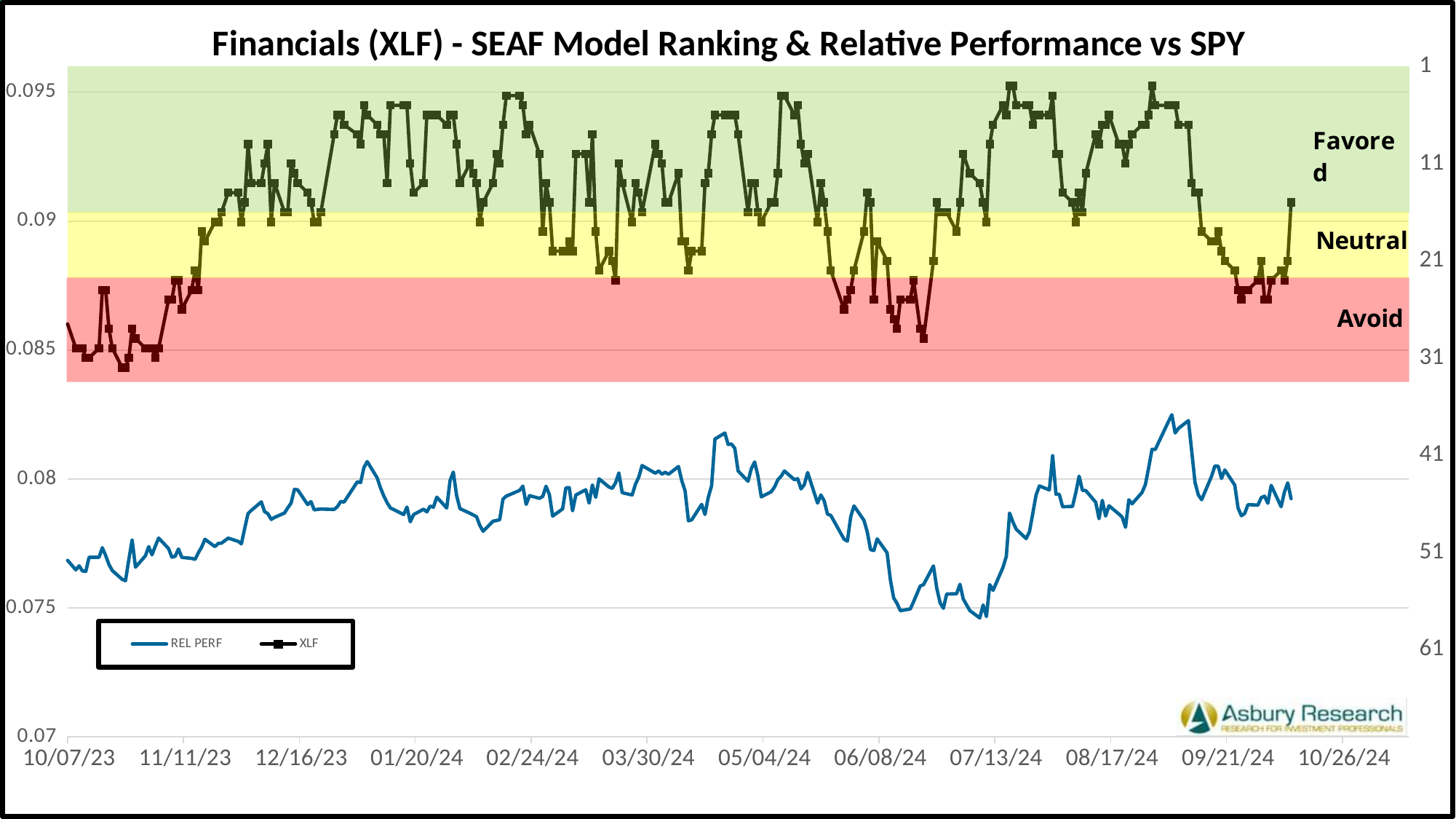
Is the highest value reached by REL PERF greater or less than 0.08? greater Does REL PERF rise or fall between 10/07/23 and 12/16/23? rise Does REL PERF rise or fall between 05/04/24 and 06/08/24? fall How many series does the legend list? 2 Is the value of REL PERF at 10/07/23 greater or less than 0.08? less What is the title of the chart? Financials (XLF) - SEAF Model Ranking & Relative Performance vs SPY Is the XLF ranking value at 10/07/23 greater or less than 21 on the right-hand axis? greater Which label is shown in the red shaded band of the chart? Avoid Which is larger, the REL PERF value at 10/07/23 or at 09/21/24? 09/21/24 What kind of chart is shown on the slide? line chart How many date labels are shown on the x axis? 12